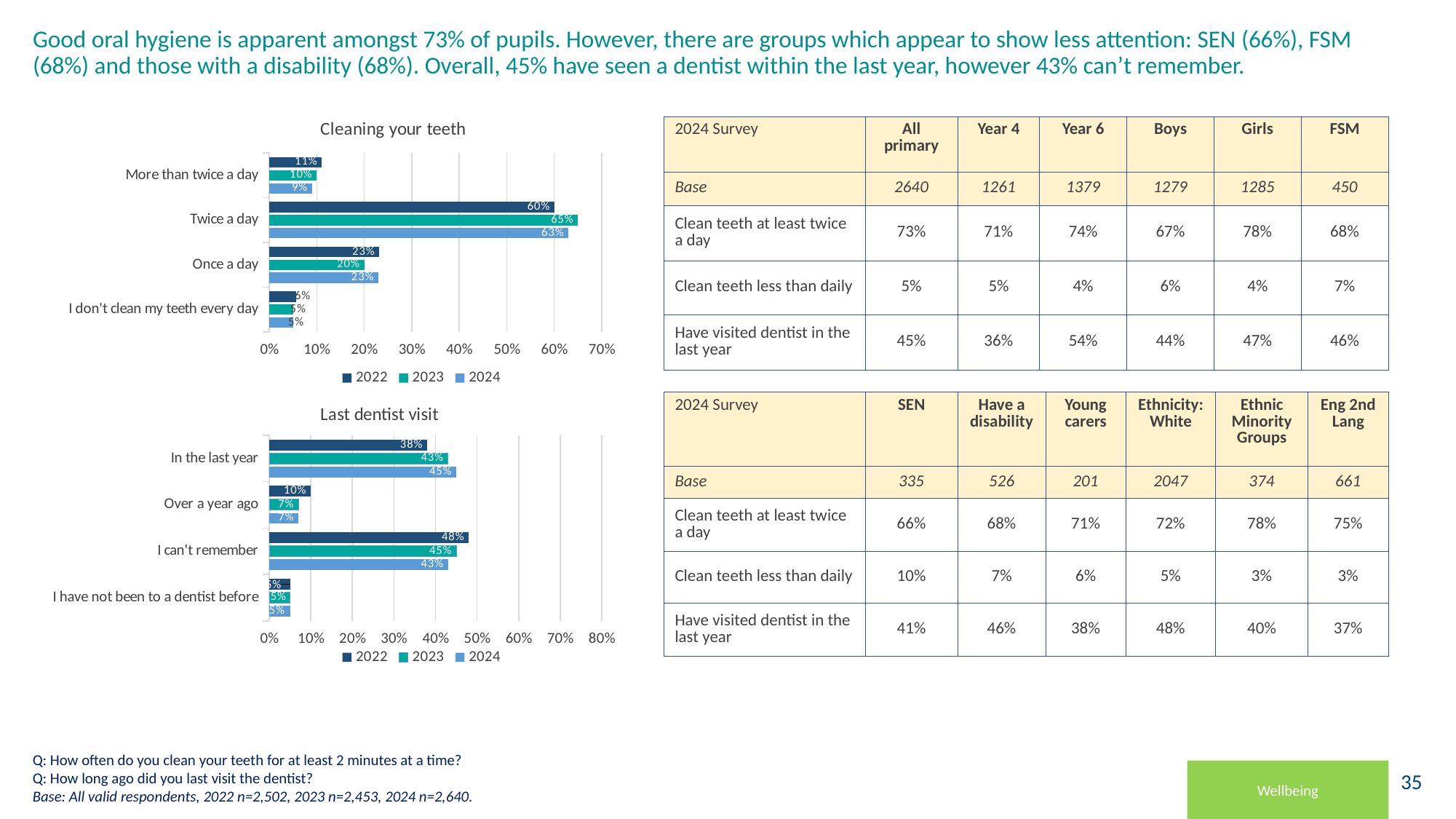
What kind of chart is the 'Last dentist visit' chart? bar chart In the 'Cleaning your teeth' chart, which category has the highest 2023 value? Twice a day In the 'Cleaning your teeth' chart, how many series does the legend list? 3 In the 'Cleaning your teeth' chart, what is the 2024 value for 'Twice a day'? 63% In the 'Last dentist visit' chart, which category has the lowest 2024 value? I have not been to a dentist before In the 'Last dentist visit' chart, what is the 2024 value for 'In the last year'? 45% In the 'Last dentist visit' chart, what is the 2022 value for 'I can't remember'? 48% In the 'Cleaning your teeth' chart, what is the 2022 value for 'Once a day'? 23% In the 'Last dentist visit' chart, how many categories are shown? 4 In the 'Cleaning your teeth' chart, what is the difference between the 2023 and 2022 values for 'Twice a day'? 5% In the 'Last dentist visit' chart, do the values for 'In the last year' rise or fall from 2022 to 2024? rise In the 'Last dentist visit' chart, is the 2022 value for 'In the last year' larger or smaller than the 2022 value for 'I can't remember'? smaller